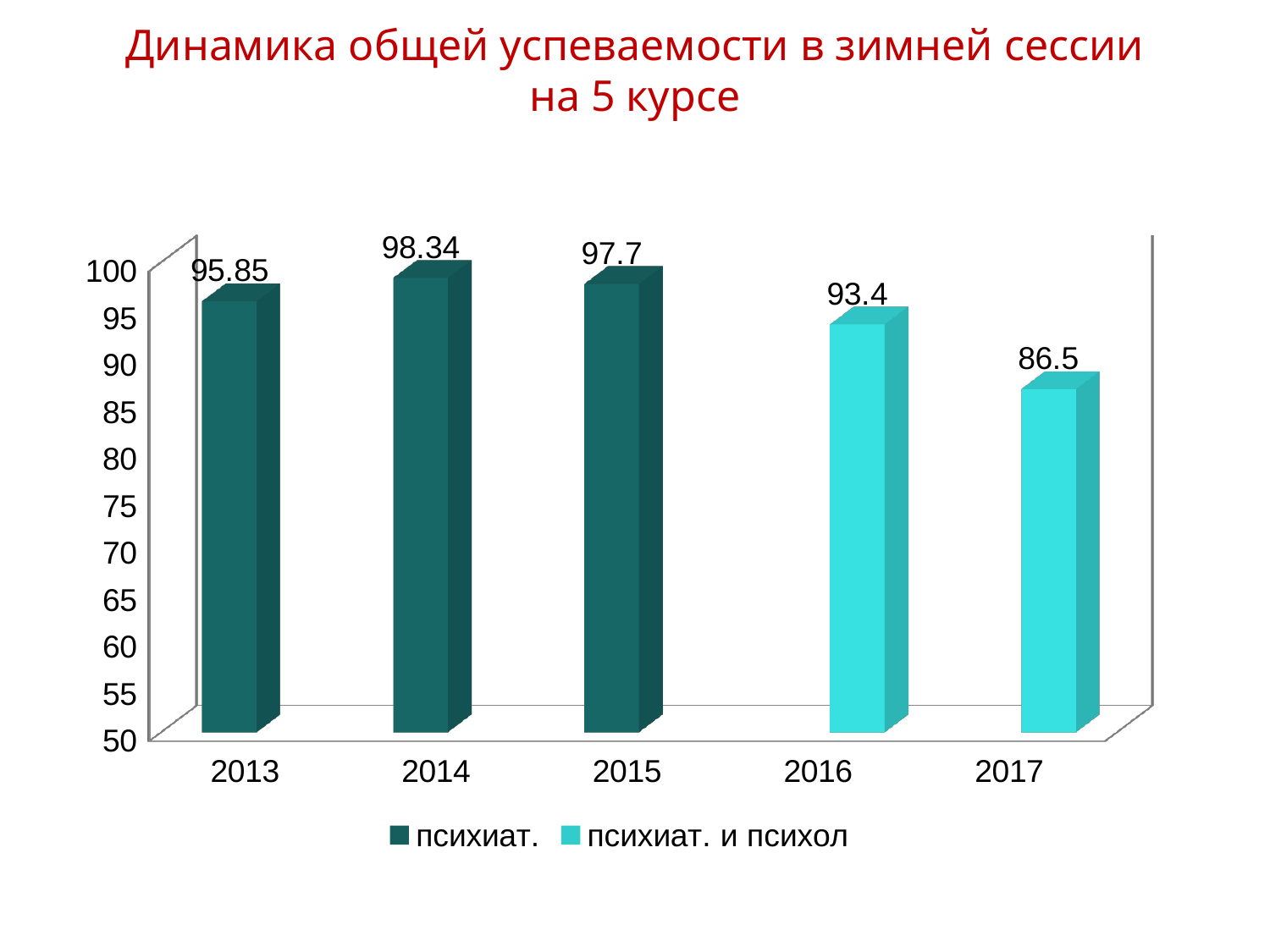
Do the values rise or fall from 2014 to 2017? fall How many years are shown on the x axis? 5 Is the value for 2017 greater or less than 90? less What is the value for 2017? 86.5 What is the difference between the values for 2014 and 2017? 11.84 What kind of chart is shown? bar chart How many series does the legend list? 2 What is the value for 2013? 95.85 Which year has the highest value? 2014 Which is larger, the value for 2015 or the value for 2016? 2015 What is the value for 2016? 93.4 Which year has the lowest value? 2017